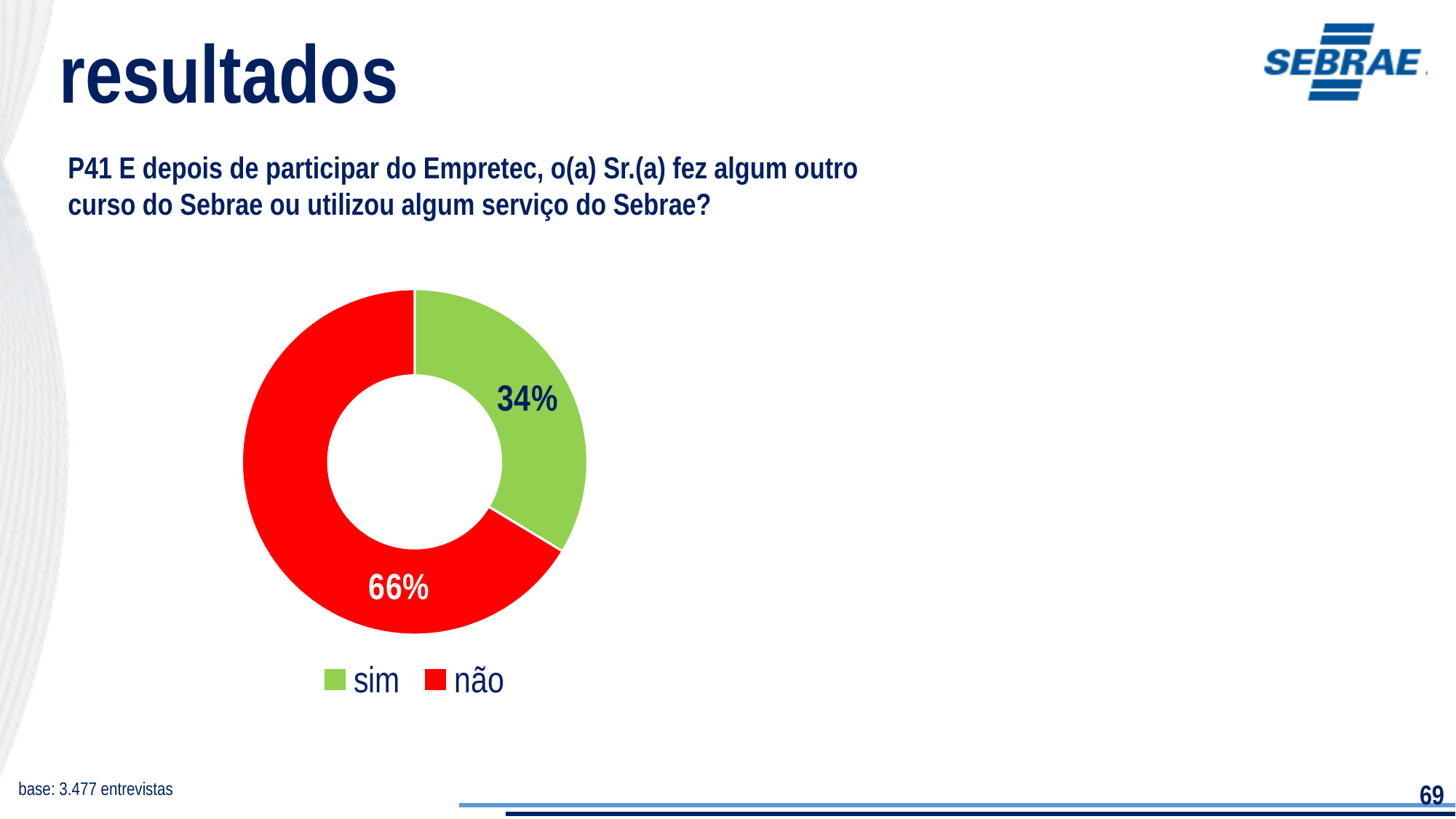
How many entries does the legend list? 2 Which is larger, the share for "sim" or the share for "não"? não What percentage of respondents answered "não"? 66% How many categories are shown in the chart? 2 What share of the chart does the "não" slice represent? 66% What percentage of respondents answered "sim"? 34% What kind of chart is shown on the slide? Doughnut (pie) chart Which response has the smallest share of the chart? sim Which response has the largest share of the chart? não What is the base (number of interviews) stated for the chart? 3.477 entrevistas What is the difference in percentage points between "não" and "sim"? 32 What colour represents "sim" in the chart? Green